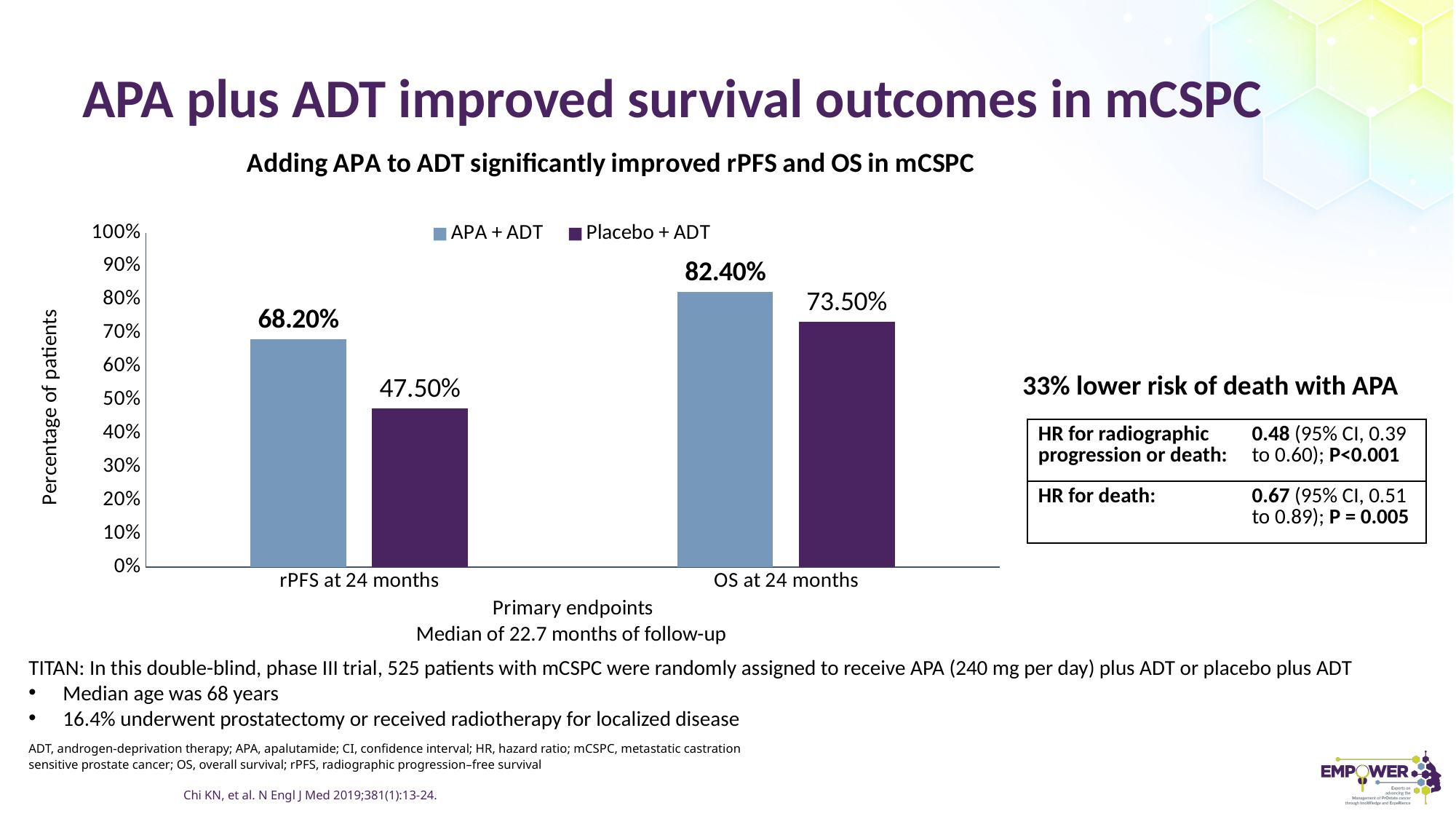
What is the difference between APA + ADT and Placebo + ADT for OS at 24 months? 8.90% How many categories are shown on the x axis? 2 Which bar has the highest value in the chart? APA + ADT, OS at 24 months What is the value for Placebo + ADT for rPFS at 24 months? 47.50% How many series does the legend list? 2 What is the difference between APA + ADT and Placebo + ADT for rPFS at 24 months? 20.70% Which bar has the lowest value in the chart? Placebo + ADT, rPFS at 24 months Which is larger for OS at 24 months: APA + ADT or Placebo + ADT? APA + ADT What kind of chart is shown on the slide? Bar chart What is the value for APA + ADT for rPFS at 24 months? 68.20% What is the value for APA + ADT for OS at 24 months? 82.40% What is the value for Placebo + ADT for OS at 24 months? 73.50%